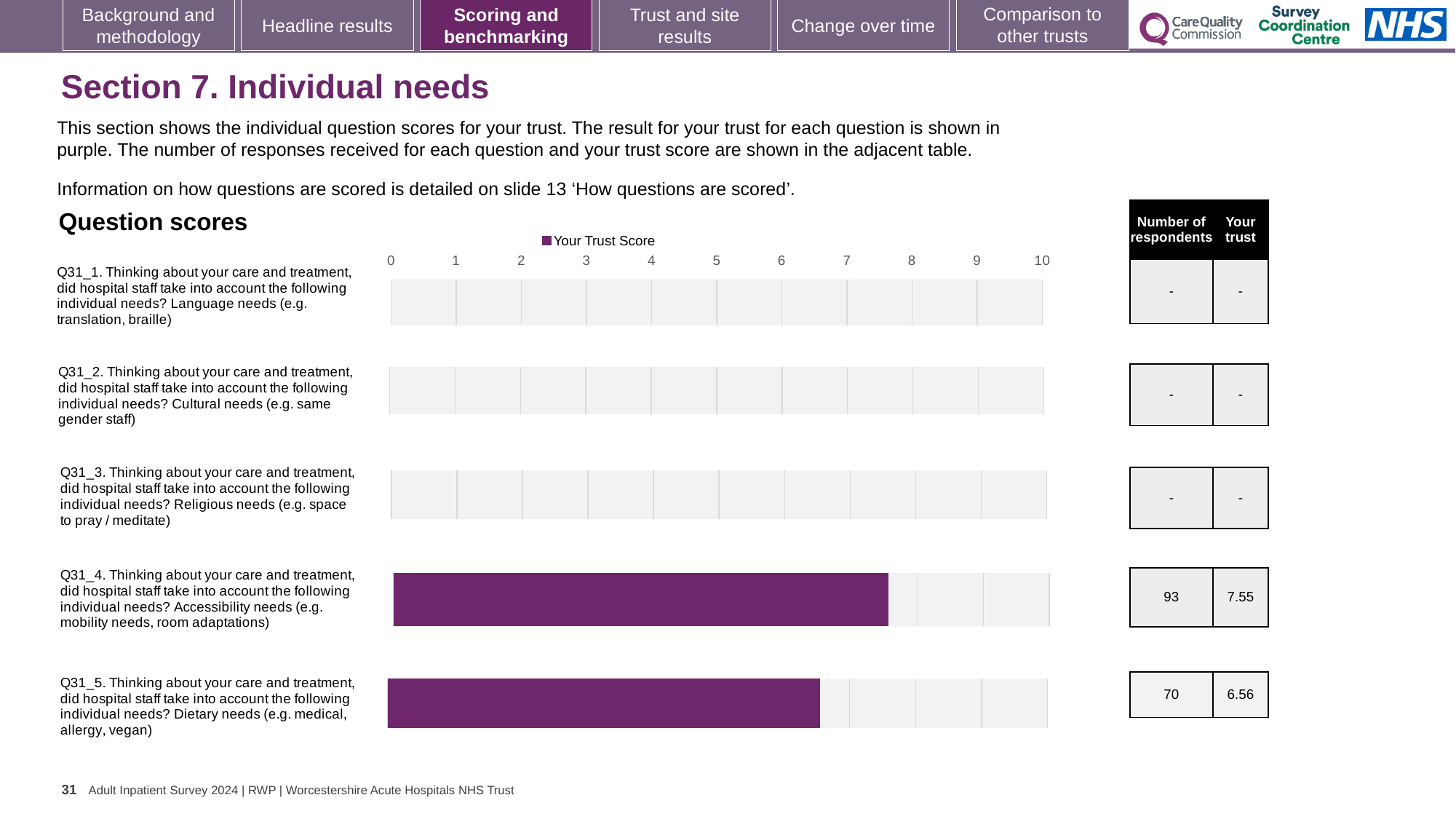
What is the trust score for Q31_5 (Dietary needs)? 6.56 How many respondents answered Q31_5 (Dietary needs)? 70 How many questions are listed on the chart? 5 Is the trust score for Q31_4 (Accessibility needs) greater or less than 7? greater What is the difference between the trust scores for Q31_4 and Q31_5? 0.99 What is the trust score for Q31_4 (Accessibility needs)? 7.55 How many respondents answered Q31_4 (Accessibility needs)? 93 Which question has the highest trust score shown on the chart? Q31_4 (Accessibility needs) What series does the chart legend list? Your Trust Score Is the trust score for Q31_5 (Dietary needs) greater or less than 7? less Which has a larger trust score, Q31_4 (Accessibility needs) or Q31_5 (Dietary needs)? Q31_4 (Accessibility needs) What type of chart is shown on the slide? Bar chart